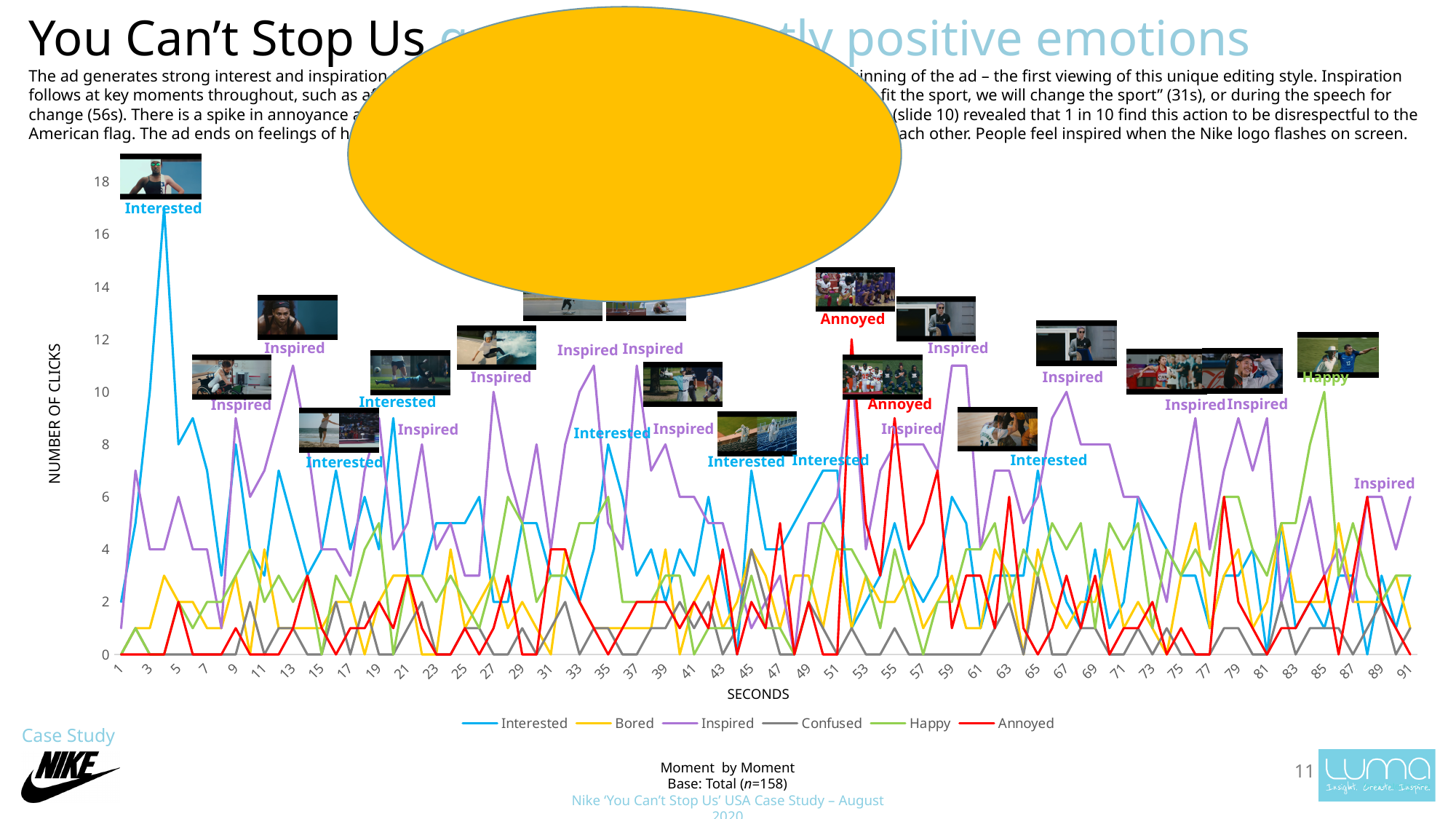
Is the value for Inspired at 13 seconds greater or less than 8? greater Is the value for Confused at 45 seconds greater or less than 6? less What is the title of the x axis? SECONDS Is the value for Annoyed at 51 seconds greater or less than 10? less Which series reaches the highest number of clicks at any point in the chart? Interested At 3 seconds, which series has the larger value, Interested or Inspired? Interested What kind of chart is shown on the slide? line chart How many series does the legend list? 6 What is the title of the y axis? NUMBER OF CLICKS